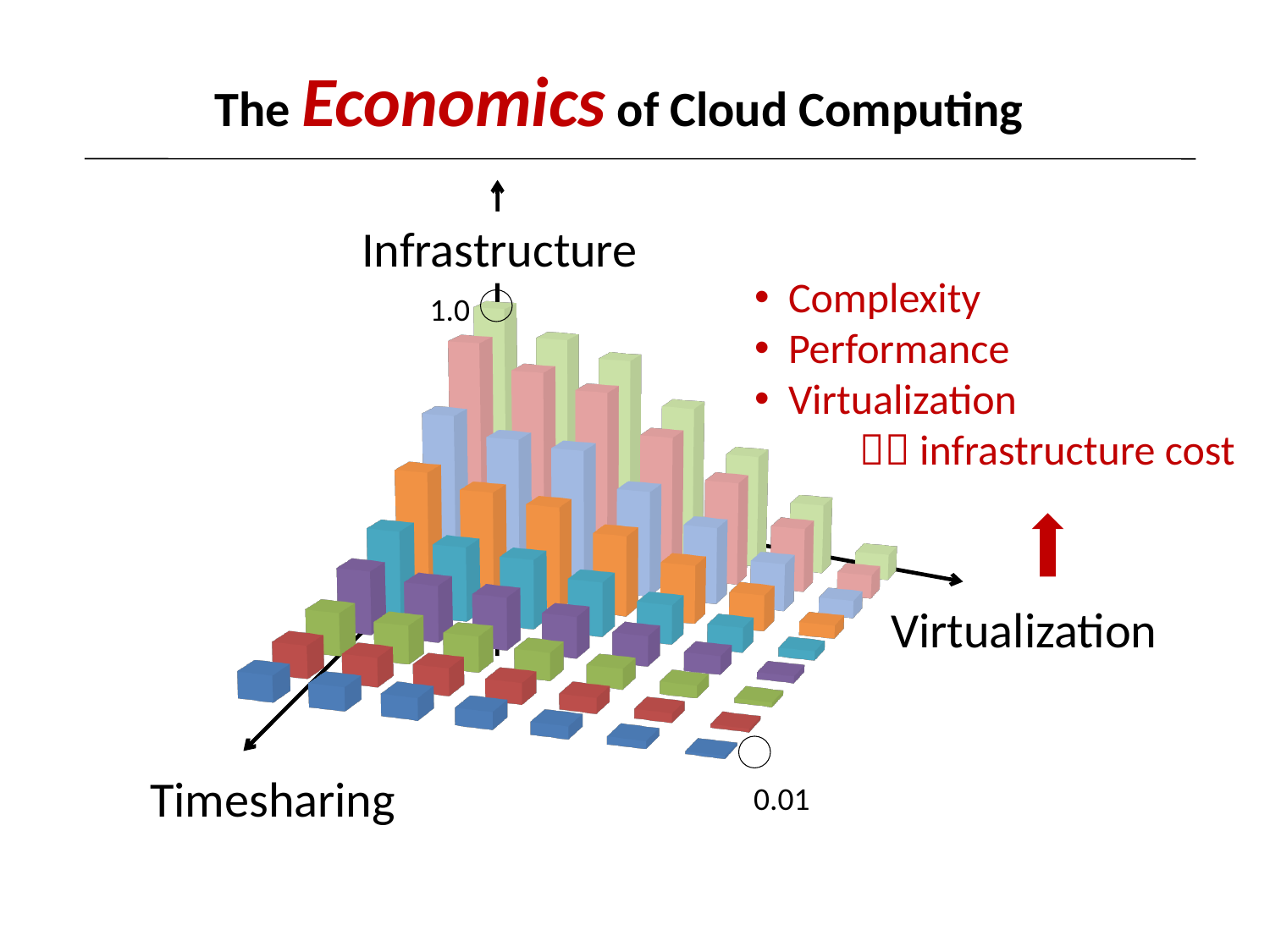
What are the two labels on the horizontal axes of the chart? Timesharing and Virtualization Which colour of bars is the shortest in every group? blue What value is marked next to the smallest bar at the front of the chart? 0.01 How many groups of bars are there along the Timesharing axis? 7 What label is on the vertical axis of the chart? Infrastructure What value is marked next to the tallest bar at the back of the chart? 1.0 Do the bar heights rise or fall as you move along the Virtualization axis toward the right? fall What kind of chart is shown on the slide? bar chart Which is taller, the bar marked 1.0 or the bar marked 0.01? the bar marked 1.0